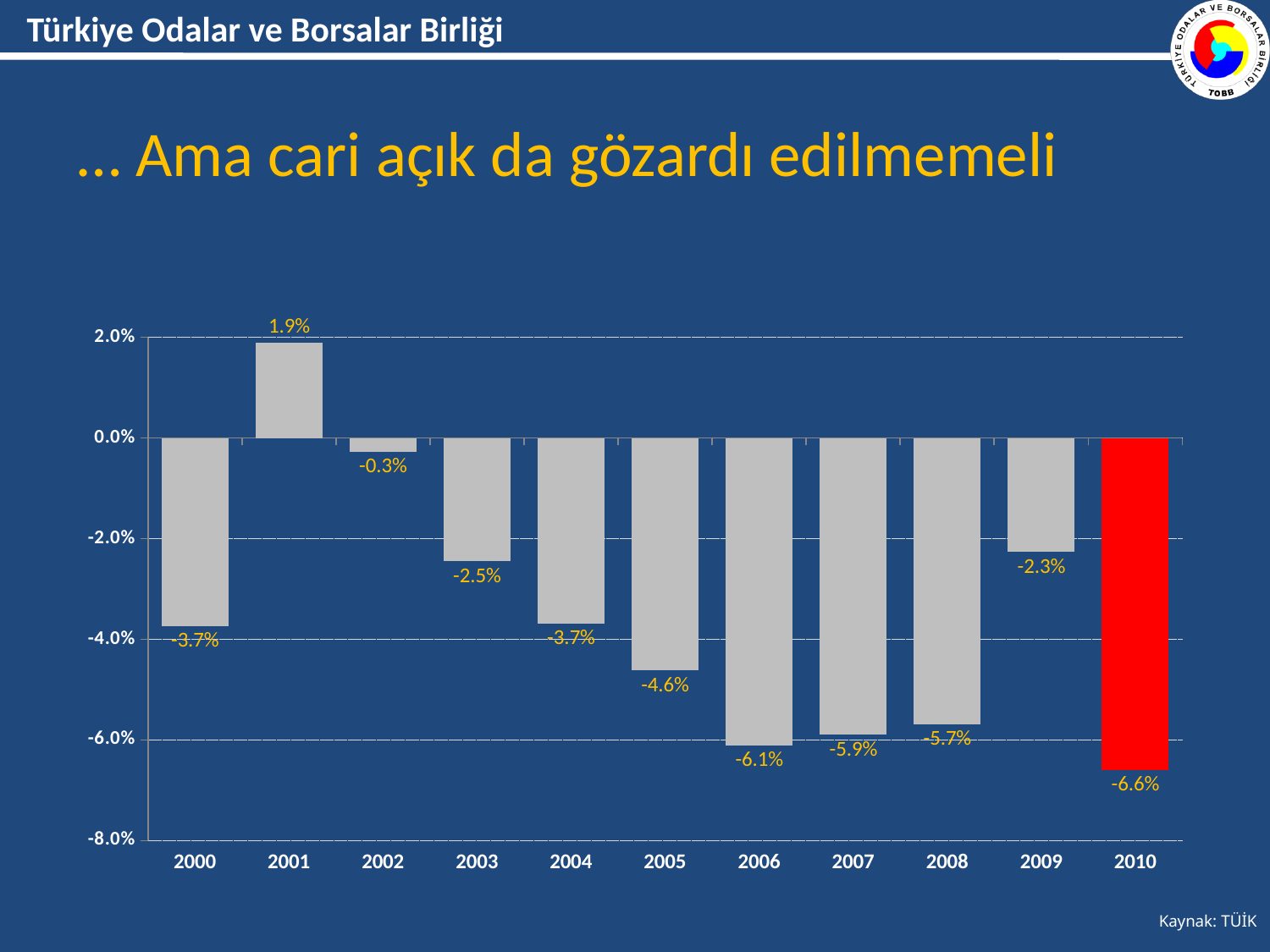
What source is cited for the chart? TÜİK Which year has the lowest value? 2010 What is the value for 2002? -0.3% How many years are shown on the x axis? 11 Which is larger, the value for 2005 or the value for 2008? 2005 Which year's bar is coloured red? 2010 Which year has the highest value? 2001 What is the value for 2006? -6.1% What kind of chart is shown on the slide? Bar chart What is the difference between the values for 2009 and 2010? 4.3 percentage points What is the value for 2001? 1.9% What is the value for 2010? -6.6%